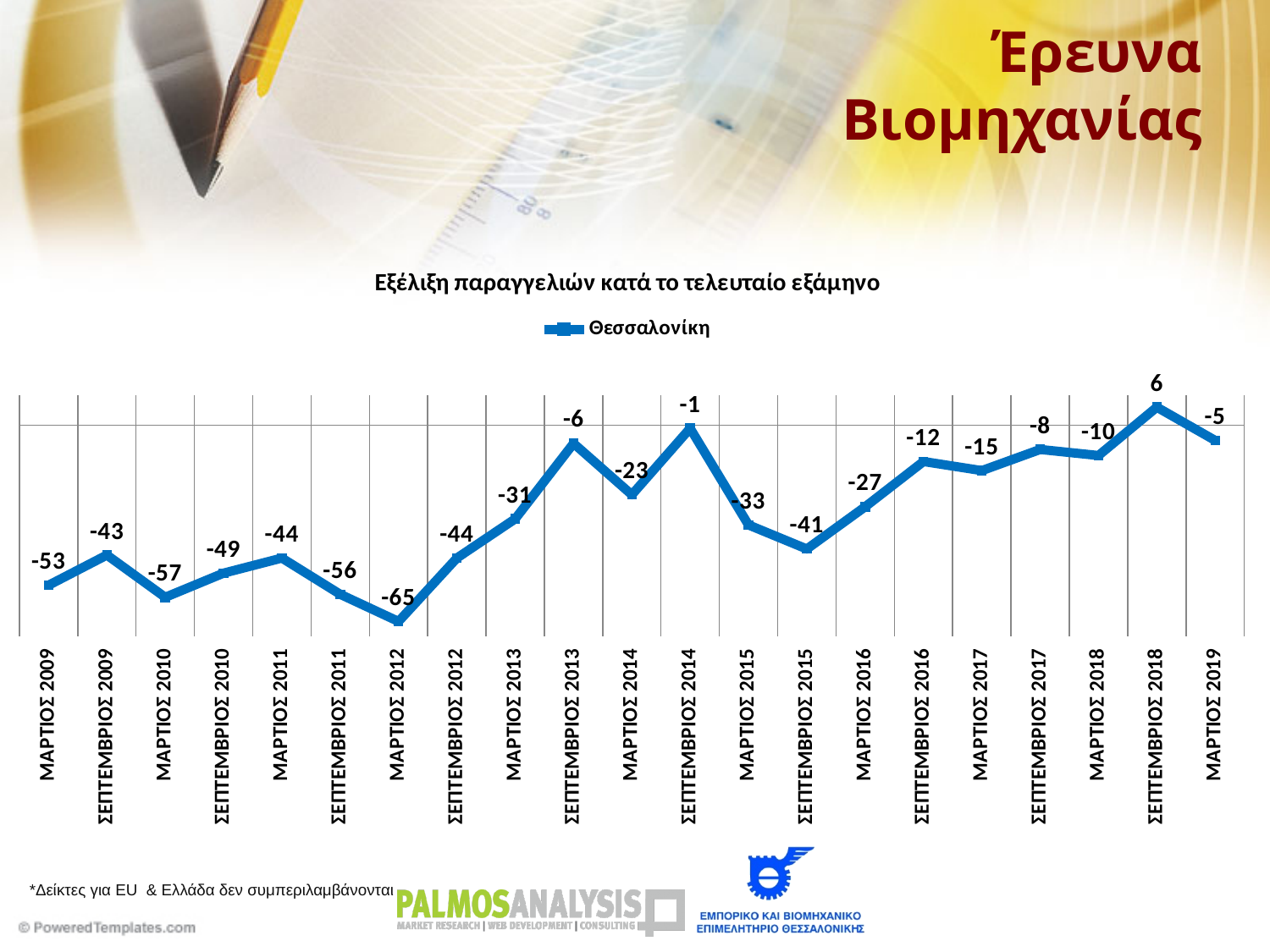
How many data points are plotted on the chart? 21 What is the value for ΣΕΠΤΕΜΒΡΙΟΣ 2014? -1 What type of chart is shown on the slide? line chart Which period has the lowest value? ΜΑΡΤΙΟΣ 2012 Which is larger, the value for ΜΑΡΤΙΟΣ 2015 or the value for ΣΕΠΤΕΜΒΡΙΟΣ 2015? ΜΑΡΤΙΟΣ 2015 Which period has the highest value? ΣΕΠΤΕΜΒΡΙΟΣ 2018 Does the value rise or fall from ΜΑΡΤΙΟΣ 2015 to ΣΕΠΤΕΜΒΡΙΟΣ 2015? fall How many series does the legend list? 1 What is the difference between the values for ΣΕΠΤΕΜΒΡΙΟΣ 2018 and ΜΑΡΤΙΟΣ 2012? 71 What is the value for ΜΑΡΤΙΟΣ 2019? -5 What is the name of the series shown in the legend? Θεσσαλονίκη What is the value for ΜΑΡΤΙΟΣ 2012? -65